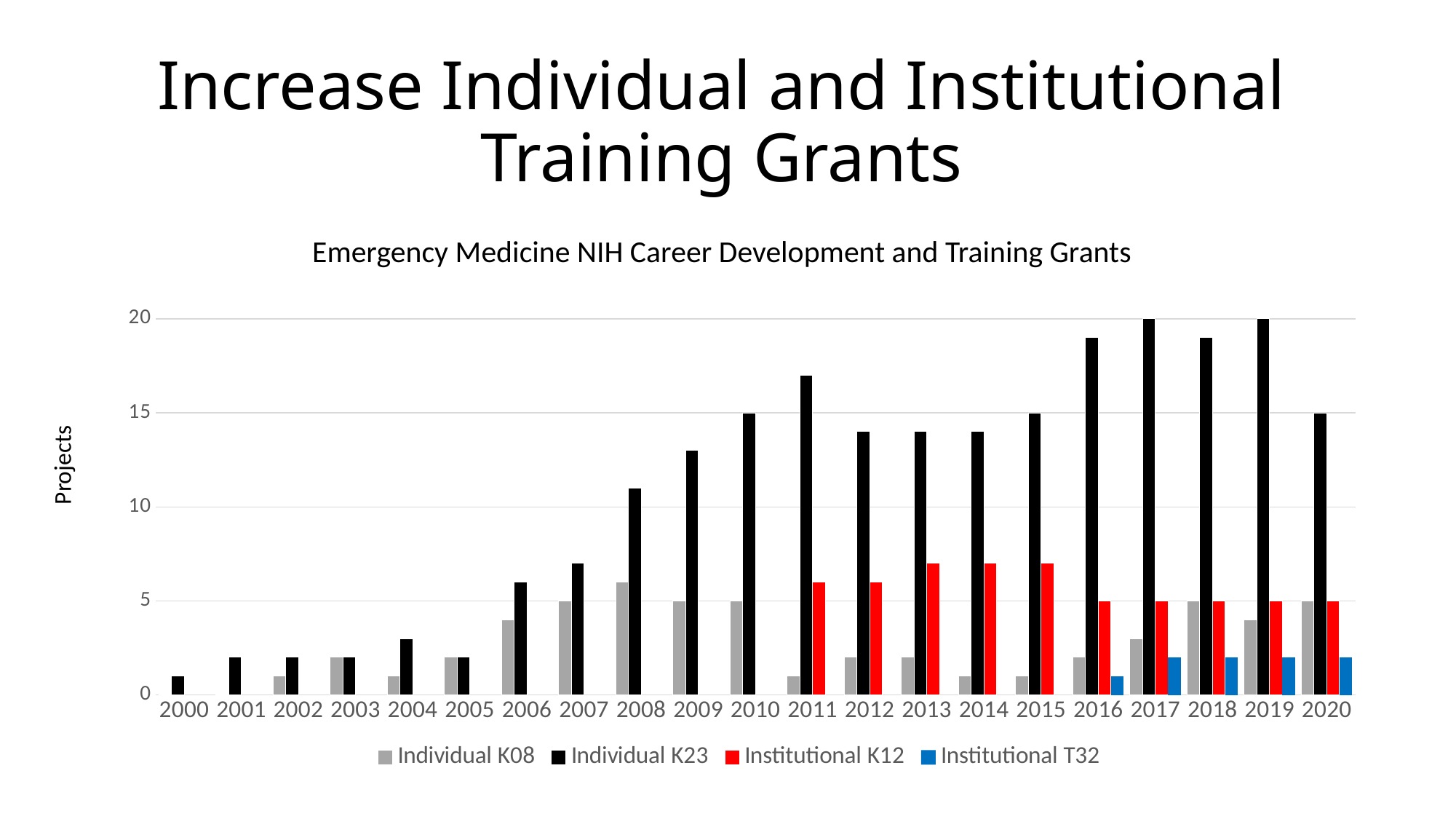
What kind of chart is shown on the slide? bar chart Which series has the lowest value in 2016? Institutional T32 What is the title of the chart? Emergency Medicine NIH Career Development and Training Grants Is the value for Individual K23 in 2016 greater or less than 15? greater Is the value for Institutional K12 in 2013 greater or less than 5? greater Which is larger, Individual K23 in 2011 or Individual K23 in 2012? 2011 Is the value for Individual K23 in 2008 greater or less than 10? greater How many series does the legend list? 4 What is the value for Individual K23 in 2020? 15 Which series has the highest value in 2013? Individual K23 How many years are shown on the x axis? 21